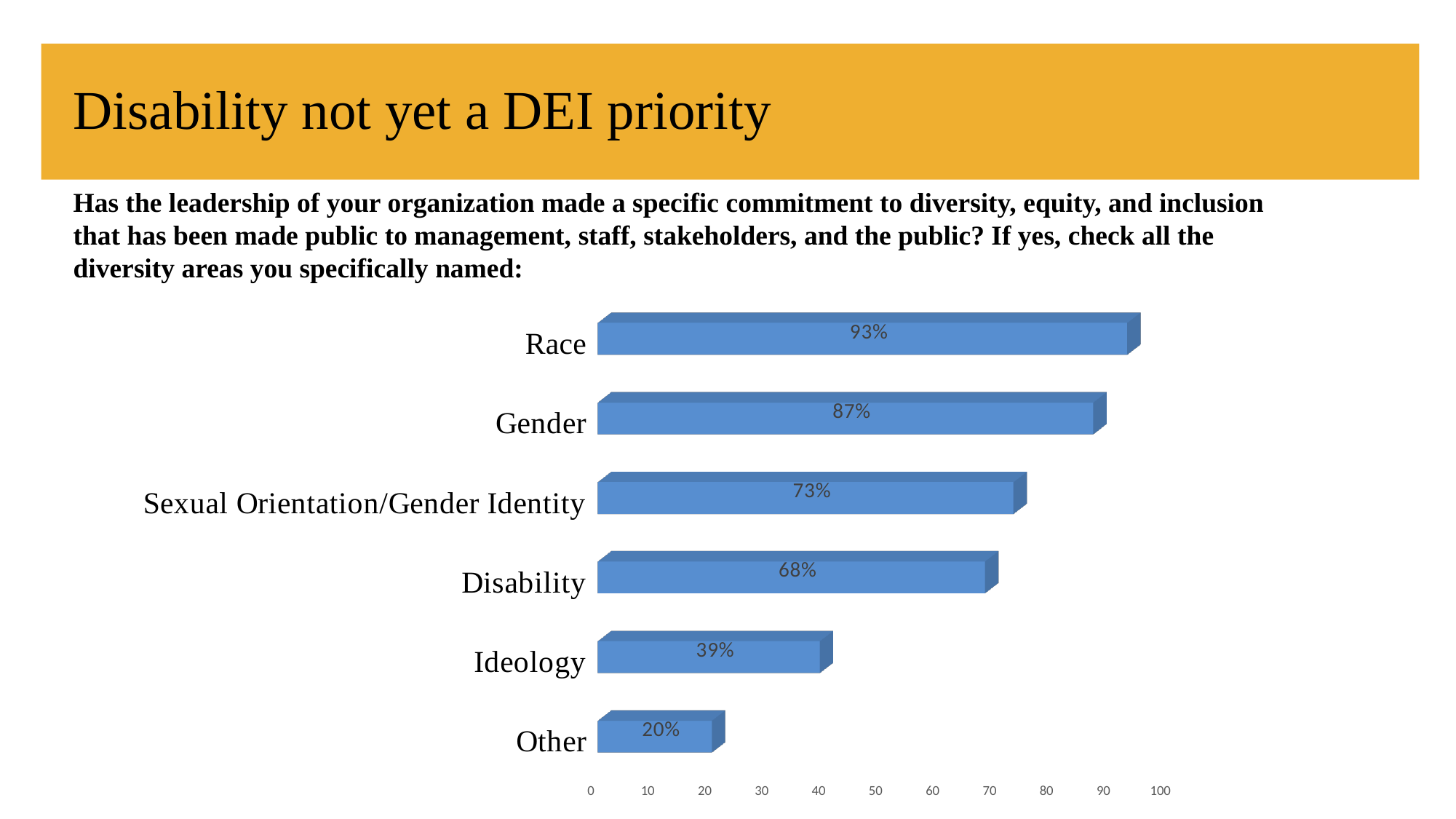
Which diversity area has the highest percentage? Race What percentage is shown for Sexual Orientation/Gender Identity? 73% What is the difference in percentage points between Race and Disability? 25 What percentage is shown for Disability? 68% What kind of chart is shown on the slide? Bar chart What percentage is shown for Ideology? 39% Which diversity area has the lowest percentage? Other What is the title of the slide containing the chart? Disability not yet a DEI priority How many diversity areas are shown in the chart? 6 What percentage is shown for Race? 93% What is the difference in percentage points between Gender and Ideology? 48 Which has a higher percentage, Gender or Sexual Orientation/Gender Identity? Gender